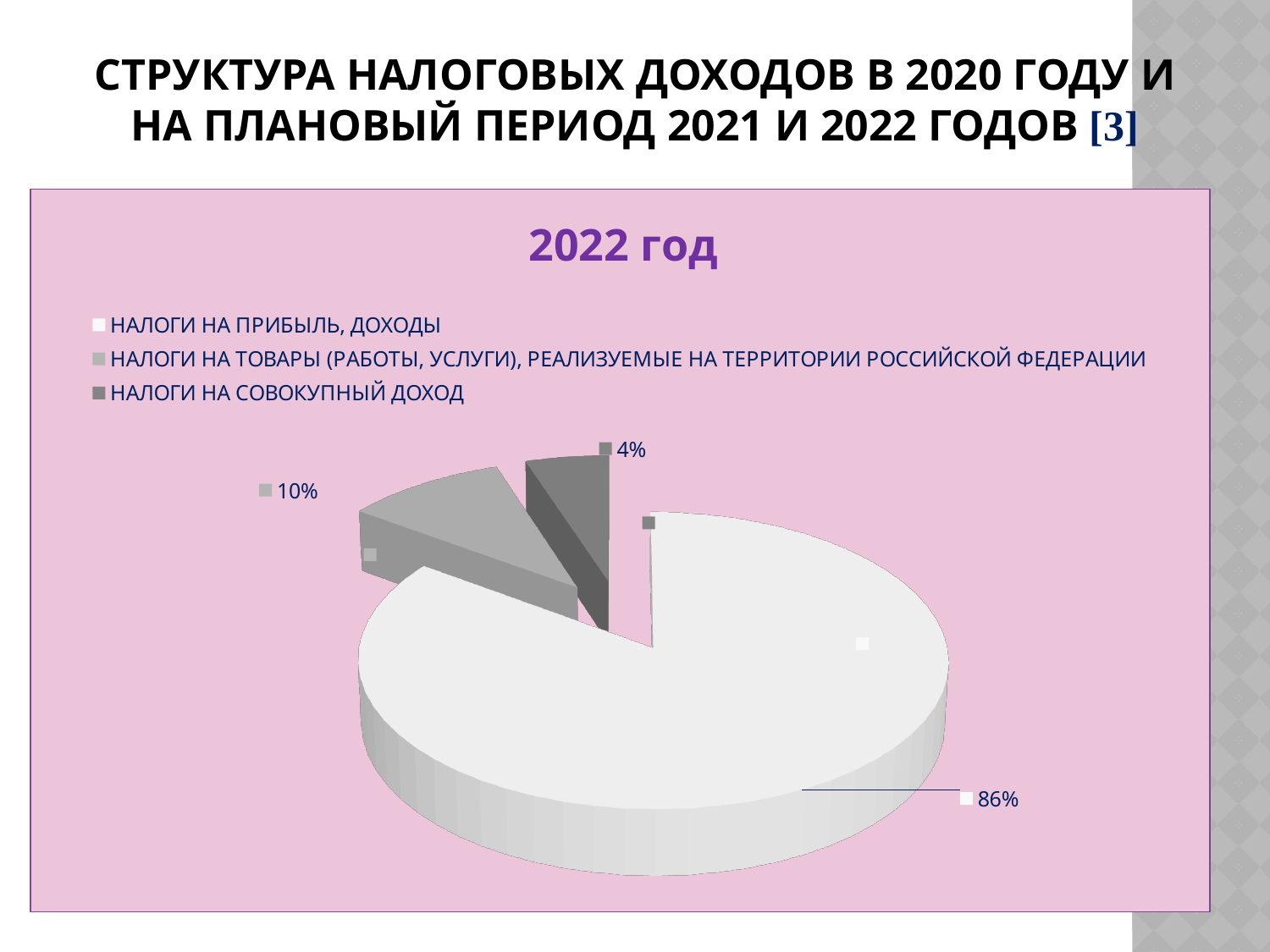
Which is larger: the share for НАЛОГИ НА ТОВАРЫ (РАБОТЫ, УСЛУГИ), РЕАЛИЗУЕМЫЕ НА ТЕРРИТОРИИ РОССИЙСКОЙ ФЕДЕРАЦИИ or for НАЛОГИ НА СОВОКУПНЫЙ ДОХОД? НАЛОГИ НА ТОВАРЫ (РАБОТЫ, УСЛУГИ), РЕАЛИЗУЕМЫЕ НА ТЕРРИТОРИИ РОССИЙСКОЙ ФЕДЕРАЦИИ Which category has the largest slice of the pie? НАЛОГИ НА ПРИБЫЛЬ, ДОХОДЫ How many categories does the pie chart show? 3 What is the difference in percentage points between НАЛОГИ НА ПРИБЫЛЬ, ДОХОДЫ and НАЛОГИ НА ТОВАРЫ (РАБОТЫ, УСЛУГИ), РЕАЛИЗУЕМЫЕ НА ТЕРРИТОРИИ РОССИЙСКОЙ ФЕДЕРАЦИИ? 76% What type of chart is shown on the slide? Pie chart How many entries does the legend list? 3 What share of the pie does НАЛОГИ НА СОВОКУПНЫЙ ДОХОД have? 4% What is the difference in percentage points between НАЛОГИ НА ТОВАРЫ (РАБОТЫ, УСЛУГИ), РЕАЛИЗУЕМЫЕ НА ТЕРРИТОРИИ РОССИЙСКОЙ ФЕДЕРАЦИИ and НАЛОГИ НА СОВОКУПНЫЙ ДОХОД? 6% What share of the pie does НАЛОГИ НА ТОВАРЫ (РАБОТЫ, УСЛУГИ), РЕАЛИЗУЕМЫЕ НА ТЕРРИТОРИИ РОССИЙСКОЙ ФЕДЕРАЦИИ have? 10% Which category has the smallest slice of the pie? НАЛОГИ НА СОВОКУПНЫЙ ДОХОД What is the title of the chart? 2022 год What share of the pie does НАЛОГИ НА ПРИБЫЛЬ, ДОХОДЫ have? 86%